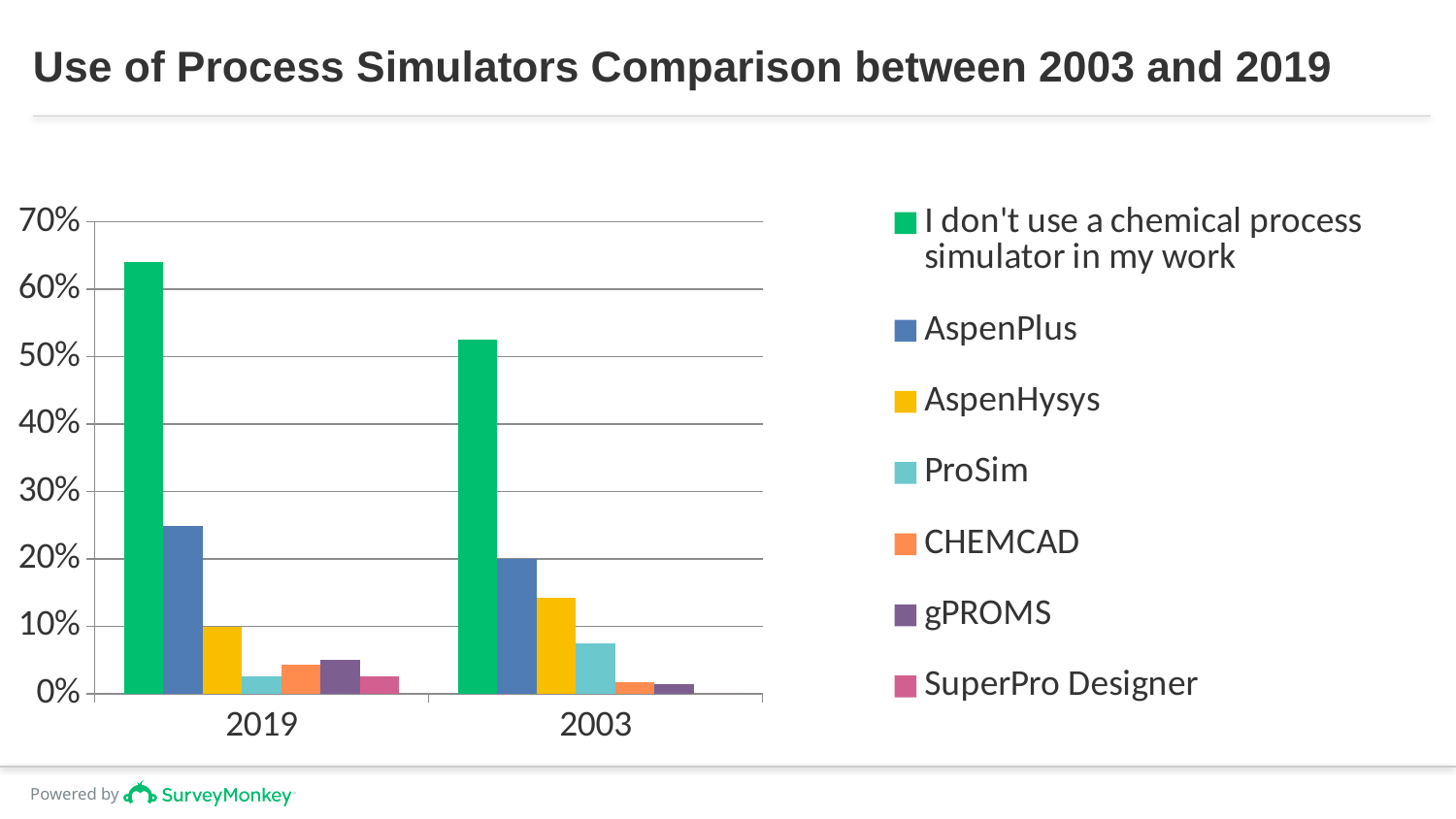
What kind of chart is shown on the slide? bar chart How many year categories are shown on the x axis? 2 Is the value for 'I don't use a chemical process simulator in my work' in 2003 greater or less than 50%? greater Which series has the highest value for 2003? I don't use a chemical process simulator in my work How many series does the legend list? 7 Is the value for AspenPlus in 2019 greater or less than 20%? greater Which year has the larger value for ProSim, 2019 or 2003? 2003 Which series has the highest value for 2019? I don't use a chemical process simulator in my work Is the value for 'I don't use a chemical process simulator in my work' in 2019 greater or less than 60%? greater What is the title of the chart? Use of Process Simulators Comparison between 2003 and 2019 Which year has the larger value for AspenPlus, 2019 or 2003? 2019 Which year has the larger value for AspenHysys, 2019 or 2003? 2003